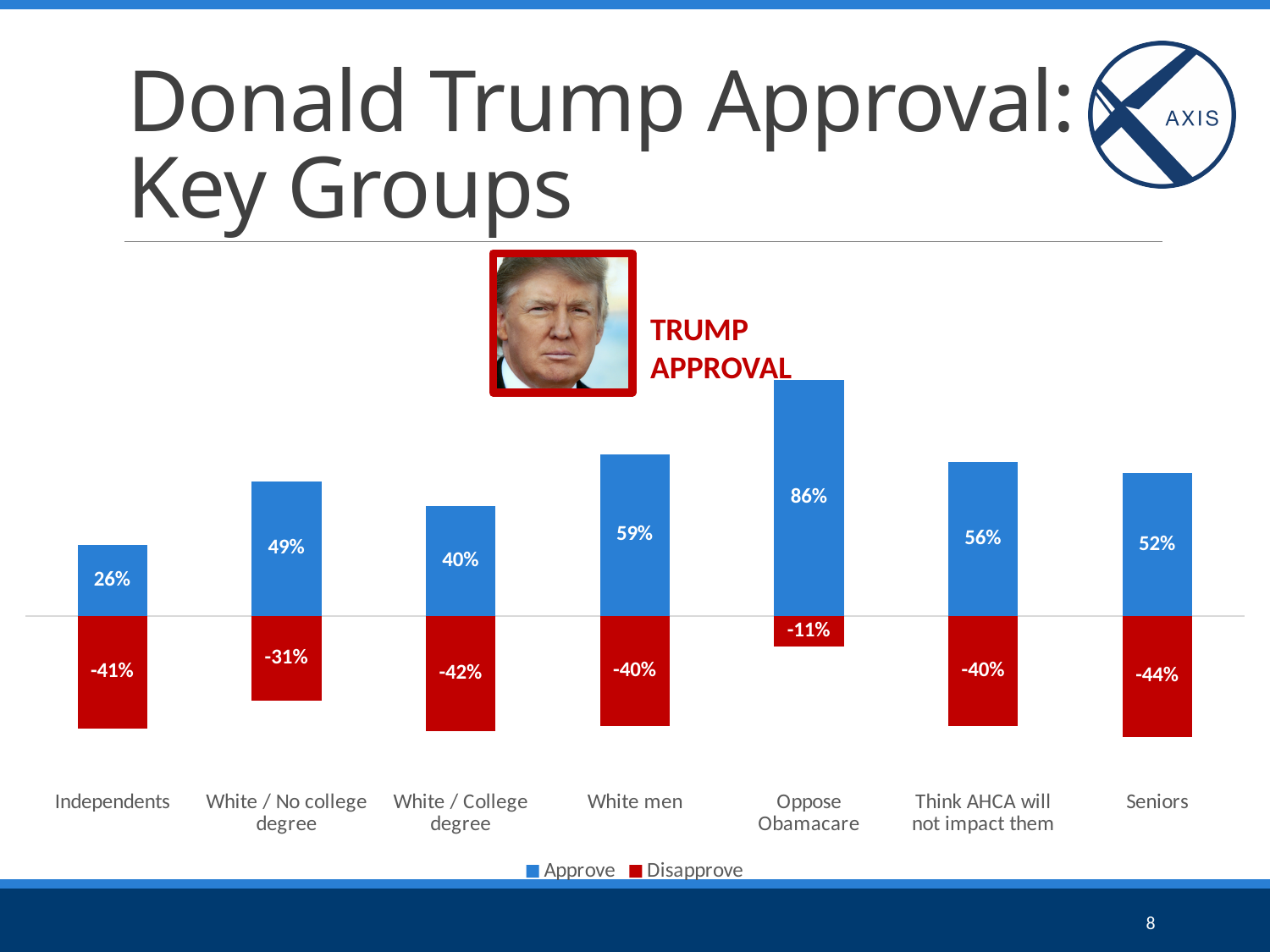
Which has a higher Approve value, Seniors or Think AHCA will not impact them? Think AHCA will not impact them What is the Disapprove value for Seniors? -44% What is the Disapprove value for Oppose Obamacare? -11% How many groups are shown on the x axis? 7 What is the Approve value for White men? 59% Which group has the lowest Approve value? Independents Which colour represents the Disapprove series? Red What is the difference between the Approve values for White men and White / College degree? 19% How many series does the legend list? 2 What is the Approve value for Independents? 26% Which group has the highest Approve value? Oppose Obamacare What kind of chart is shown on the slide? Bar chart